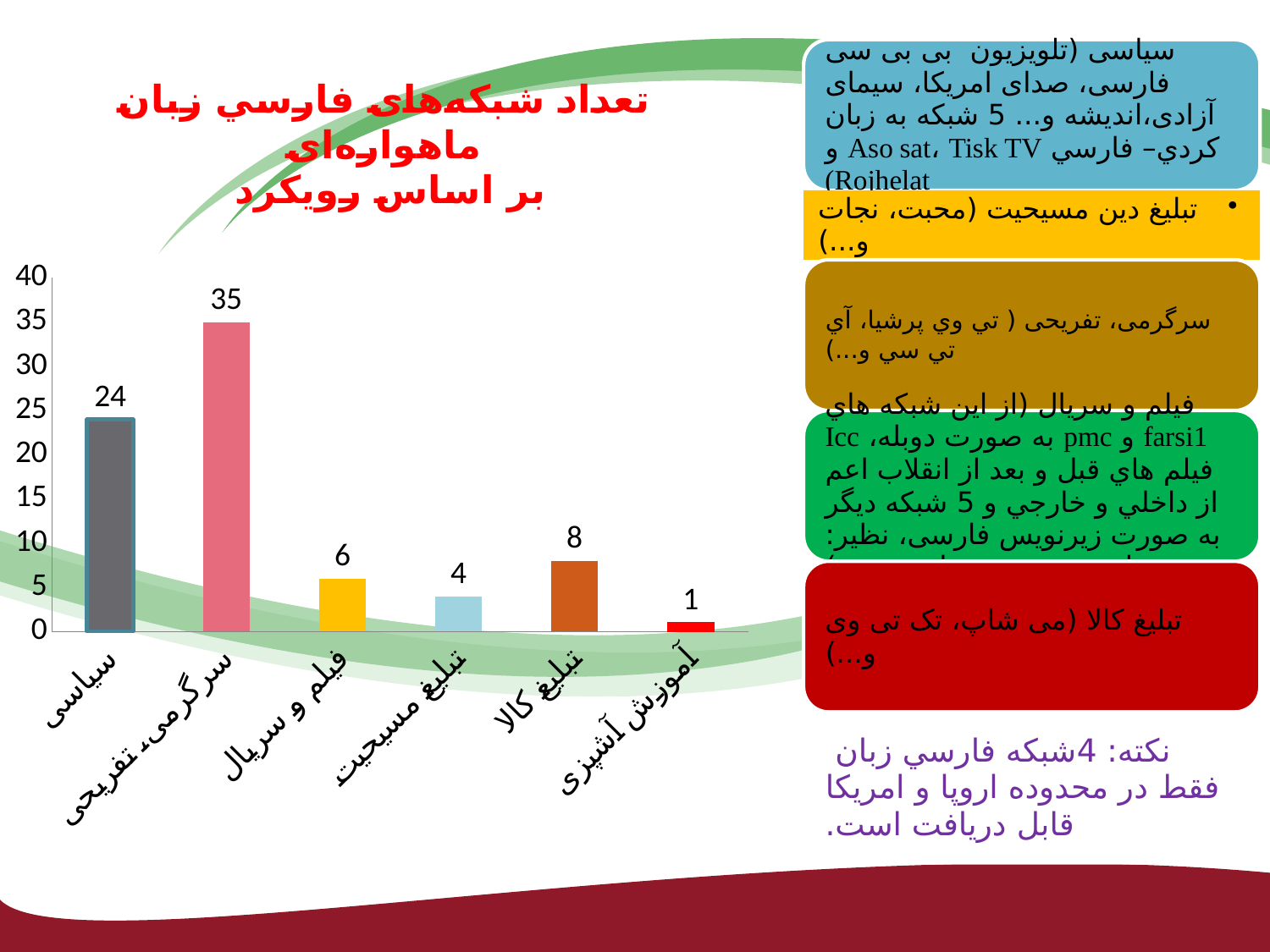
What is the value for the سیاسی category? 24 What is the value for the سرگرمی،تفریحی category? 35 Which category has the highest value? سرگرمی،تفریحی What is the difference between the values for تبلیغ کالا and تبلیغ مسیحیت? 4 What is the difference between the values for سرگرمی،تفریحی and سیاسی? 11 Is the value for سیاسی greater or less than 20? greater What kind of chart is shown on the slide? bar chart How many categories are shown on the x axis of the chart? 6 Which is larger, the value for فیلم و سریال or the value for تبلیغ مسیحیت? فیلم و سریال What is the value for the تبلیغ کالا category? 8 Which category has the lowest value? آموزش آشپزی What is the value for the آموزش آشپزی category? 1